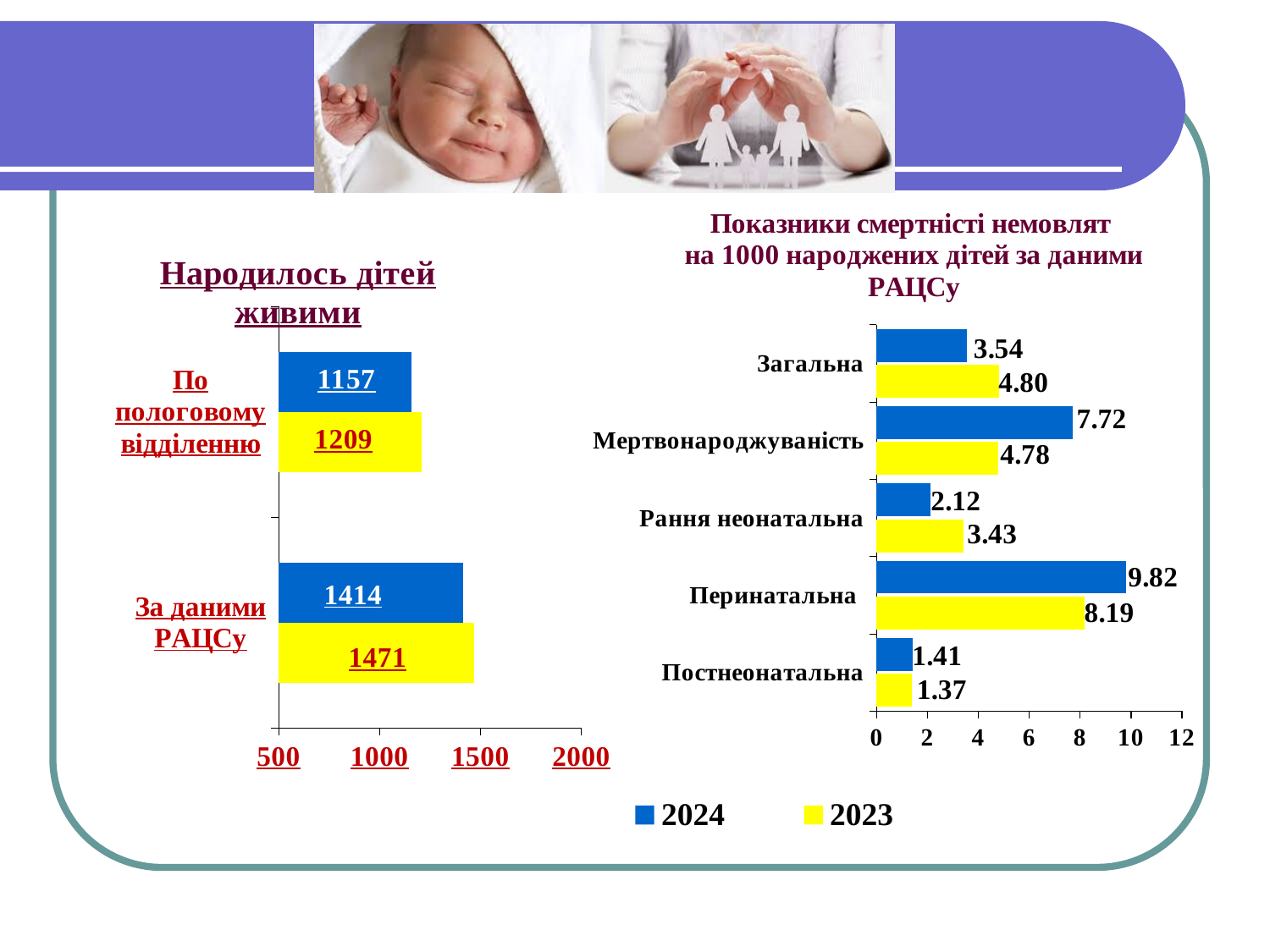
In the chart titled "Народилось дітей живими", which is larger for "По пологовому відділенню": the 2024 value or the 2023 value? 2023 In the chart titled "Показники смертністі немовлят на 1000 народжених дітей за даними РАЦСу", what is the 2024 value for "Перинатальна"? 9.82 In the chart titled "Показники смертністі немовлят на 1000 народжених дітей за даними РАЦСу", which category has the lowest 2023 value? Постнеонатальна In the chart titled "Показники смертністі немовлят на 1000 народжених дітей за даними РАЦСу", which category has the highest 2024 value? Перинатальна In the chart titled "Показники смертністі немовлят на 1000 народжених дітей за даними РАЦСу", what is the 2023 value for "Мертвонароджуваність"? 4.78 In the chart titled "Народилось дітей живими", what is the value for "За даними РАЦСу" in 2023? 1471 In the chart titled "Народилось дітей живими", how many categories are shown? 2 In the chart titled "Народилось дітей живими", what is the value for "По пологовому відділенню" in 2024? 1157 In the chart titled "Показники смертністі немовлят на 1000 народжених дітей за даними РАЦСу", how many categories are shown? 5 In the chart titled "Народилось дітей живими", what is the difference between the 2023 and 2024 values for "За даними РАЦСу"? 57 How many series does the legend at the bottom of the slide list? 2 In the chart titled "Показники смертністі немовлят на 1000 народжених дітей за даними РАЦСу", what is the difference between the 2024 and 2023 values for "Мертвонароджуваність"? 2.94